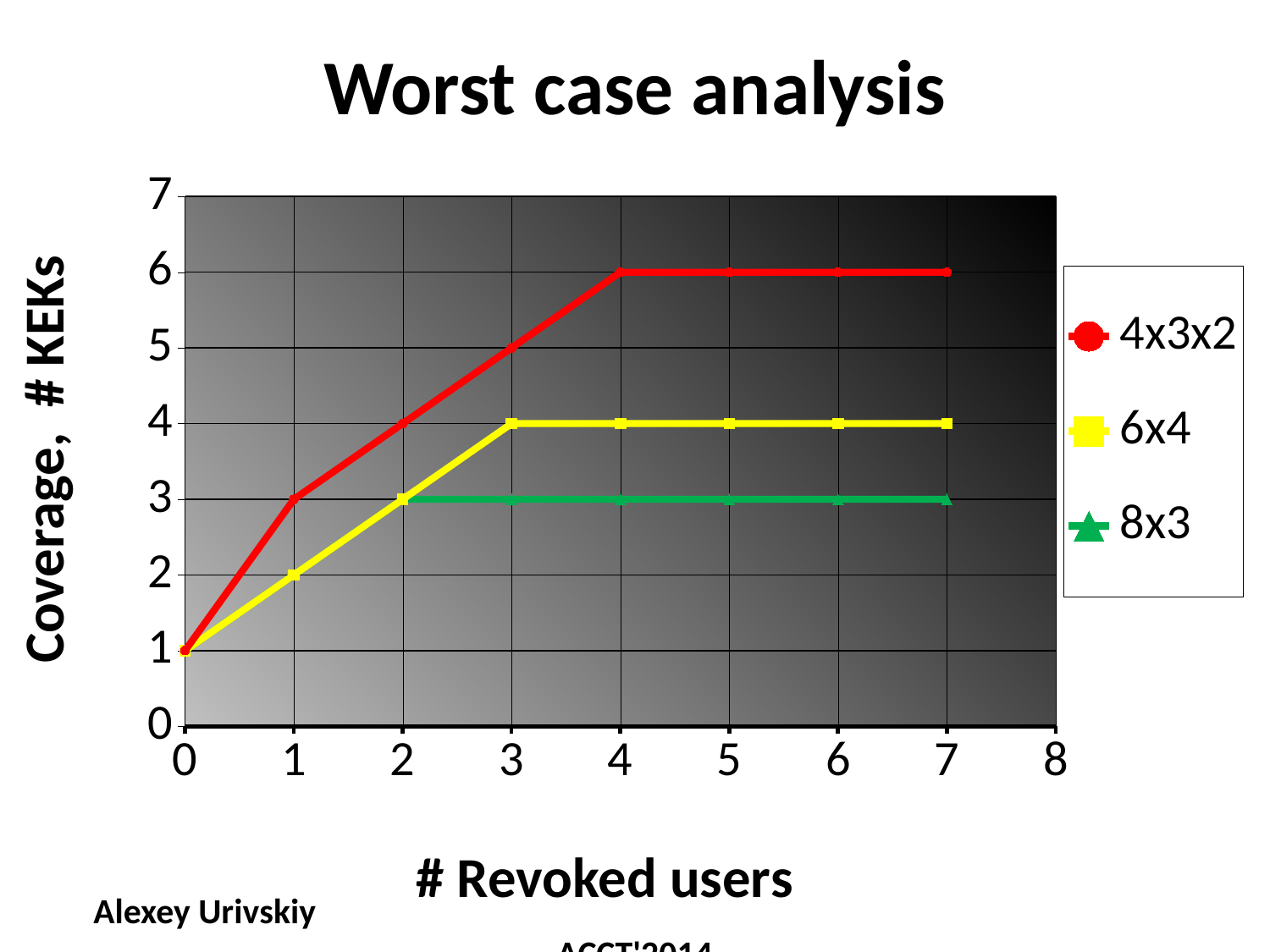
What is the value of the 8x3 series at 2 revoked users? 3 What is the value of the 4x3x2 series at 1 revoked user? 3 Does the 4x3x2 series rise or fall between 0 and 4 revoked users? rise What is the value of the 6x4 series at 3 revoked users? 4 What is the difference between the 4x3x2 and 8x3 values at 7 revoked users? 3 Which series reaches the highest value at 7 revoked users? 4x3x2 How many series does the legend list? 3 What is the title of the chart? Worst case analysis What kind of chart is shown on the slide? line chart What is the value of the 4x3x2 series at 7 revoked users? 6 What is the label of the x axis? # Revoked users Which series has the lowest value at 7 revoked users? 8x3